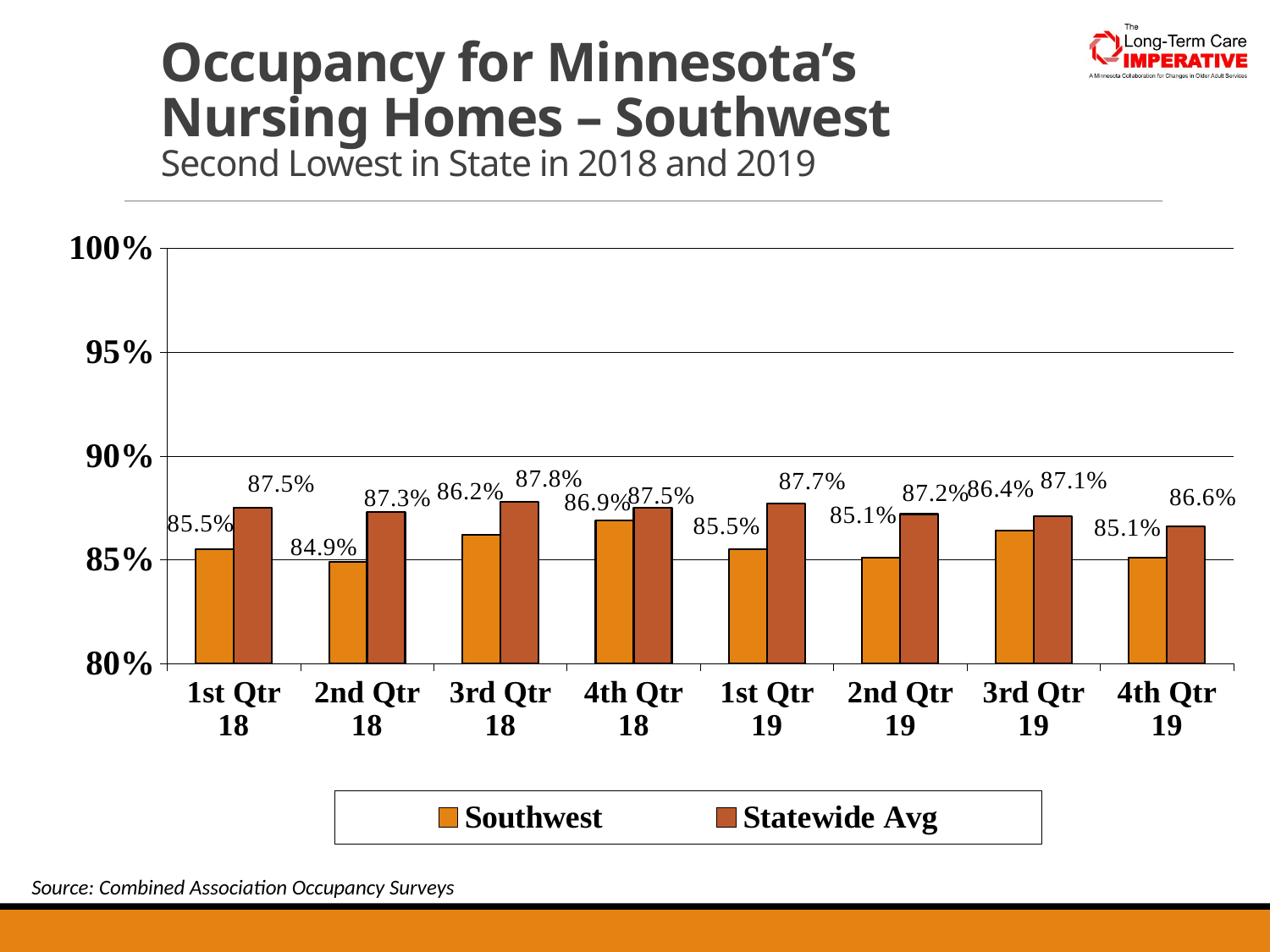
In which quarter is the Southwest occupancy highest? 4th Qtr 18 In which quarter is the Southwest occupancy lowest? 2nd Qtr 18 What kind of chart is shown on the slide? Bar chart In which quarter is the Statewide Avg occupancy lowest? 4th Qtr 19 Which is larger in 1st Qtr 19, the Southwest value or the Statewide Avg value? Statewide Avg What is the difference between the Statewide Avg and Southwest values in 2nd Qtr 18? 2.4 percentage points What is the Statewide Avg occupancy value for 3rd Qtr 18? 87.8% What is the Southwest occupancy value for 2nd Qtr 18? 84.9% How many quarters are shown on the x axis? 8 What is the Southwest occupancy value for 4th Qtr 19? 85.1% What is the difference between the Statewide Avg and Southwest values in 4th Qtr 18? 0.6 percentage points How many series does the legend list? 2